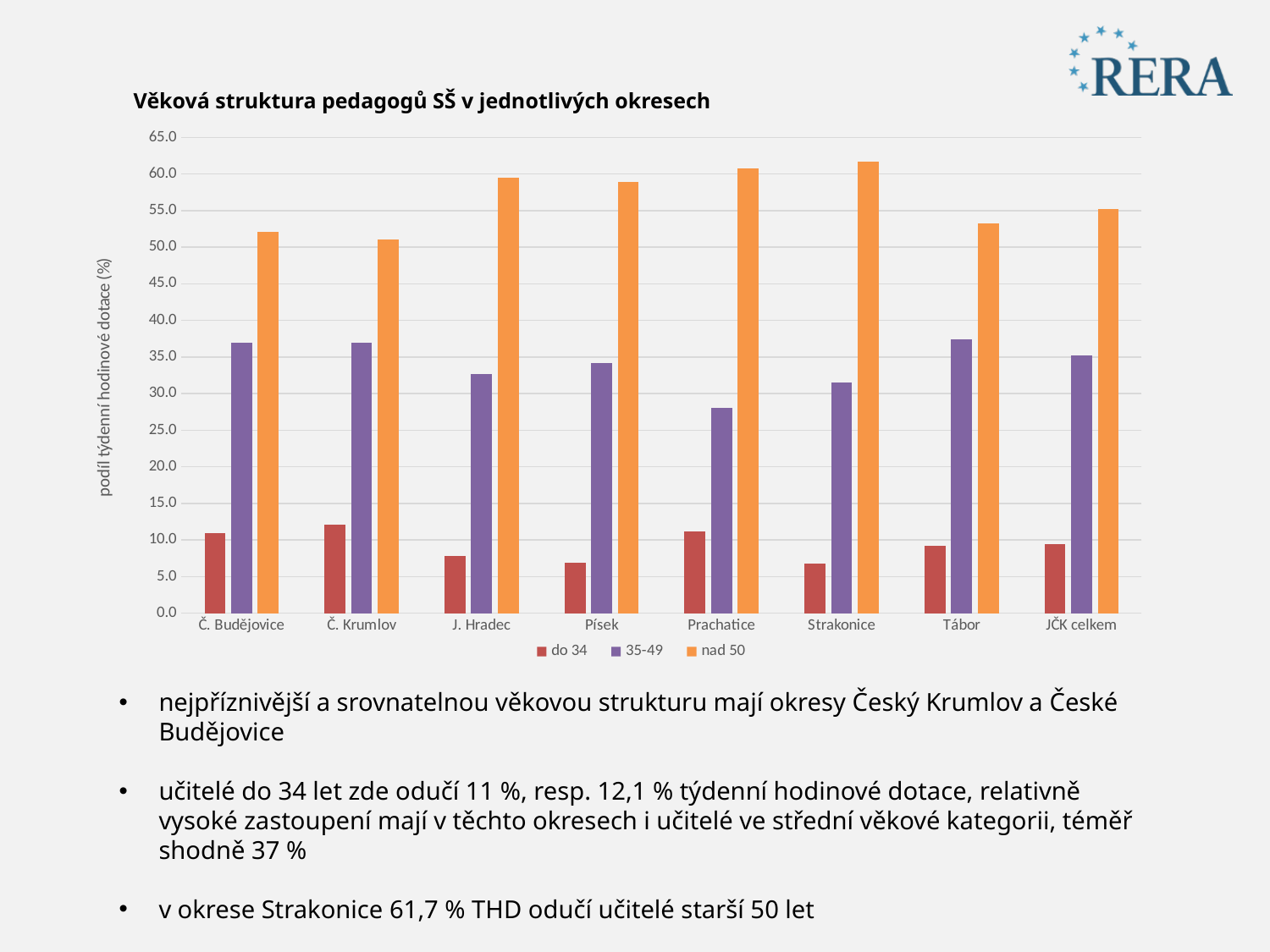
Which is larger: the 35-49 value for Prachatice or for Strakonice? Strakonice Which is larger: the nad 50 value for Č. Budějovice or for J. Hradec? J. Hradec Is the value for nad 50 in Strakonice greater or less than 60? greater What is the title of the chart? Věková struktura pedagogů SŠ v jednotlivých okresech What kind of chart is shown on the slide? bar chart What is the label of the vertical axis? podíl týdenní hodinové dotace (%) Is the value for 35-49 in Prachatice greater or less than 30? less How many districts (categories) are shown on the x axis? 8 Is the value for do 34 in J. Hradec greater or less than 10? less Which district has the lowest value for the 35-49 series? Prachatice How many series does the legend list? 3